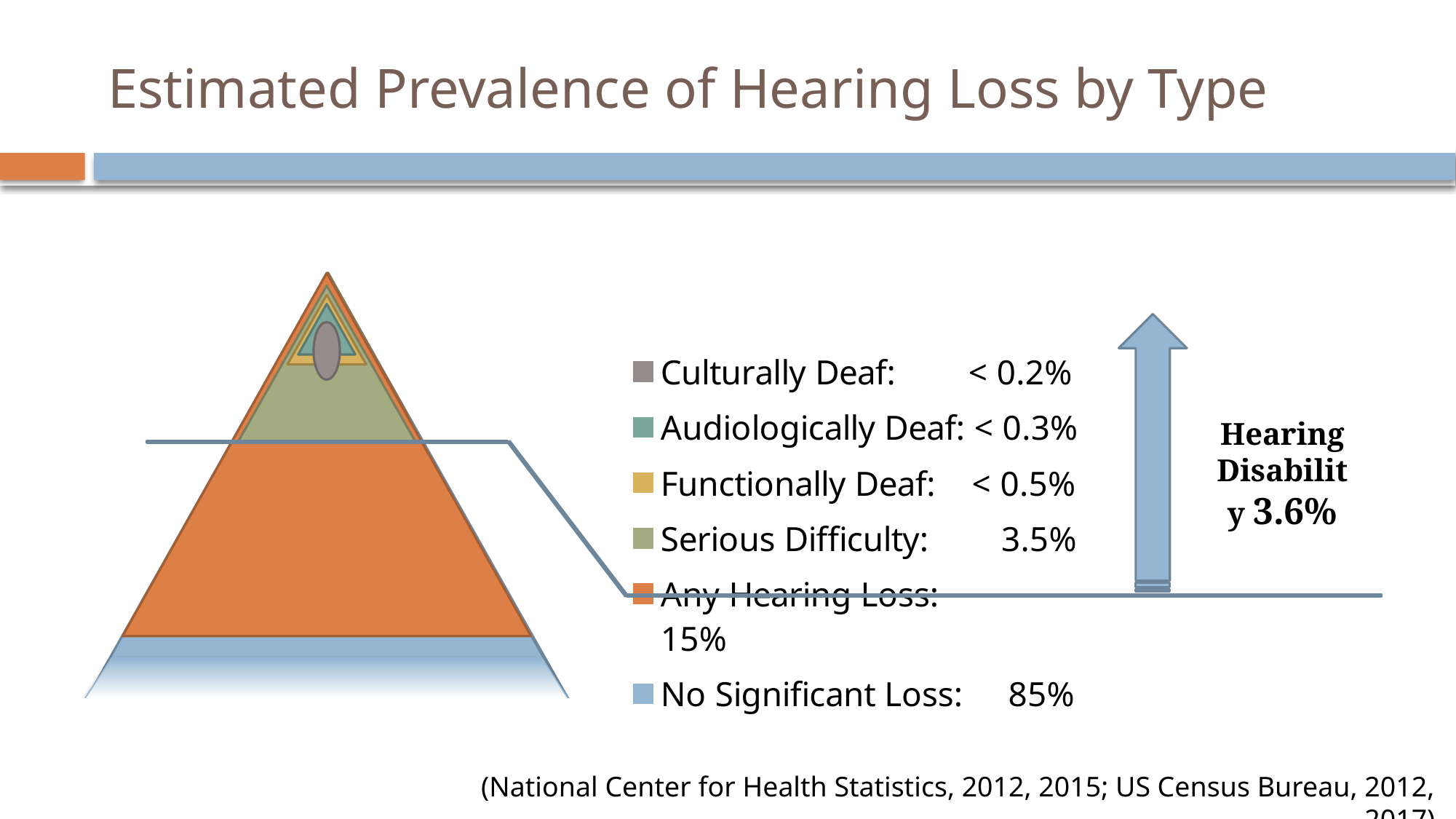
What percentage is given for Serious Difficulty? 3.5% What is the estimated prevalence of Audiologically Deaf shown on the slide? < 0.3% Which category in the legend has the largest percentage? No Significant Loss What is the estimated prevalence of Functionally Deaf shown on the slide? < 0.5% What percentage is given for Any Hearing Loss? 15% What percentage is given for No Significant Loss? 85% What is the difference between the percentages for No Significant Loss and Any Hearing Loss? 70% How many categories are listed in the legend? 6 Which is larger, the percentage for Serious Difficulty or for Any Hearing Loss? Any Hearing Loss What kind of chart is used to show the hearing loss categories? Pyramid chart What percentage is given for Hearing Disability next to the arrow? 3.6% What is the estimated prevalence of Culturally Deaf shown on the slide? < 0.2%